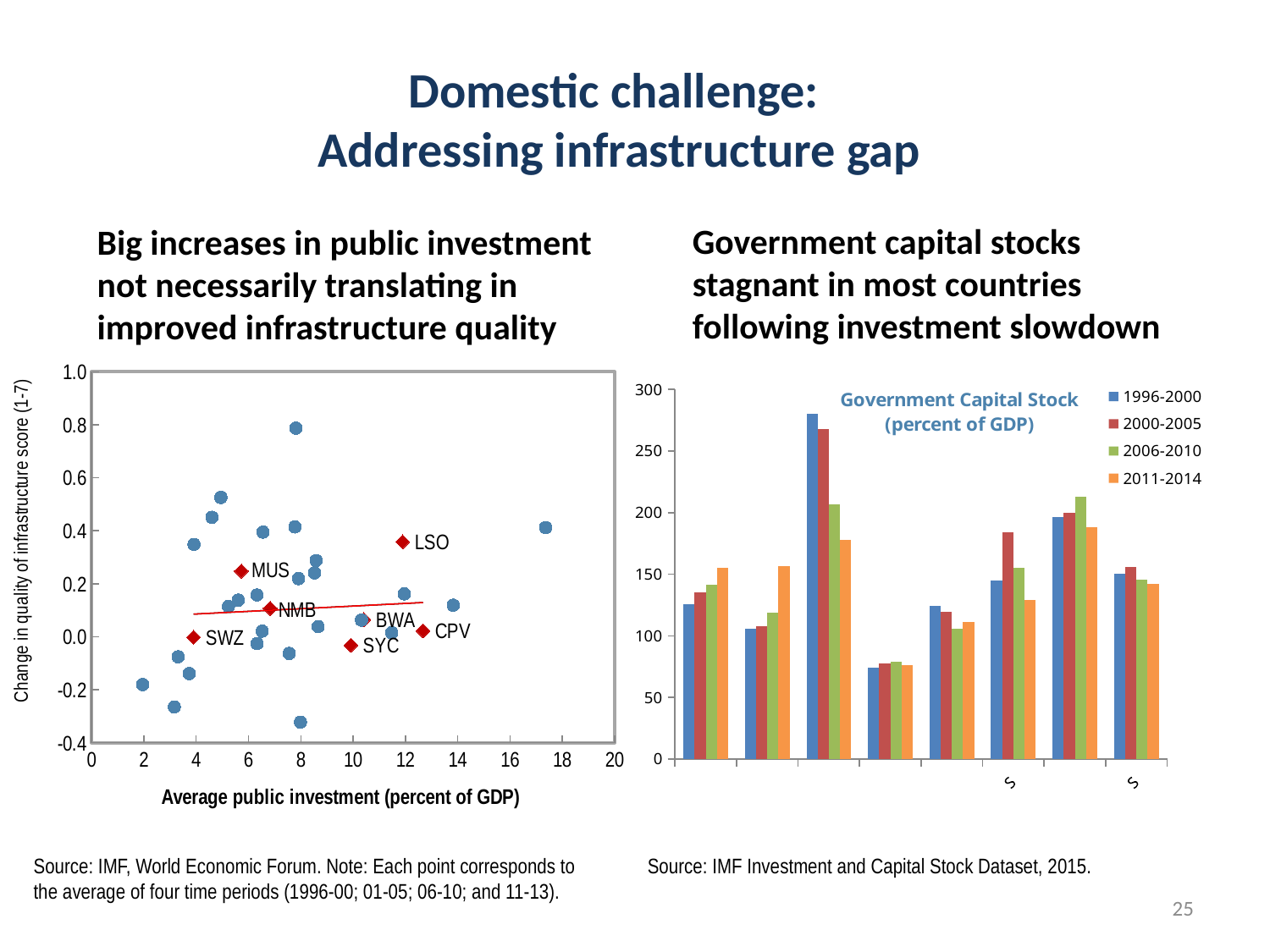
How many series does the legend of the Government Capital Stock chart list? 4 In the left scatter chart, which labeled point has the higher change in infrastructure quality score, LSO or CPV? LSO In the left scatter chart, is the average public investment for LSO greater or less than 10? greater In the left scatter chart, is the average public investment for NMB greater or less than 6? greater In the left scatter chart, is the change in quality of infrastructure score for LSO greater or less than 0.2? greater How many labeled (red diamond) points are there in the left scatter chart? 7 What are the legend entries of the Government Capital Stock chart? 1996-2000, 2000-2005, 2006-2010, 2011-2014 What kind of chart is the Government Capital Stock chart on the right? bar chart What kind of chart is the left chart on the slide? scatter chart What is the x-axis title of the left scatter chart? Average public investment (percent of GDP) In the left scatter chart, which of the labeled points has the highest change in quality of infrastructure score? LSO